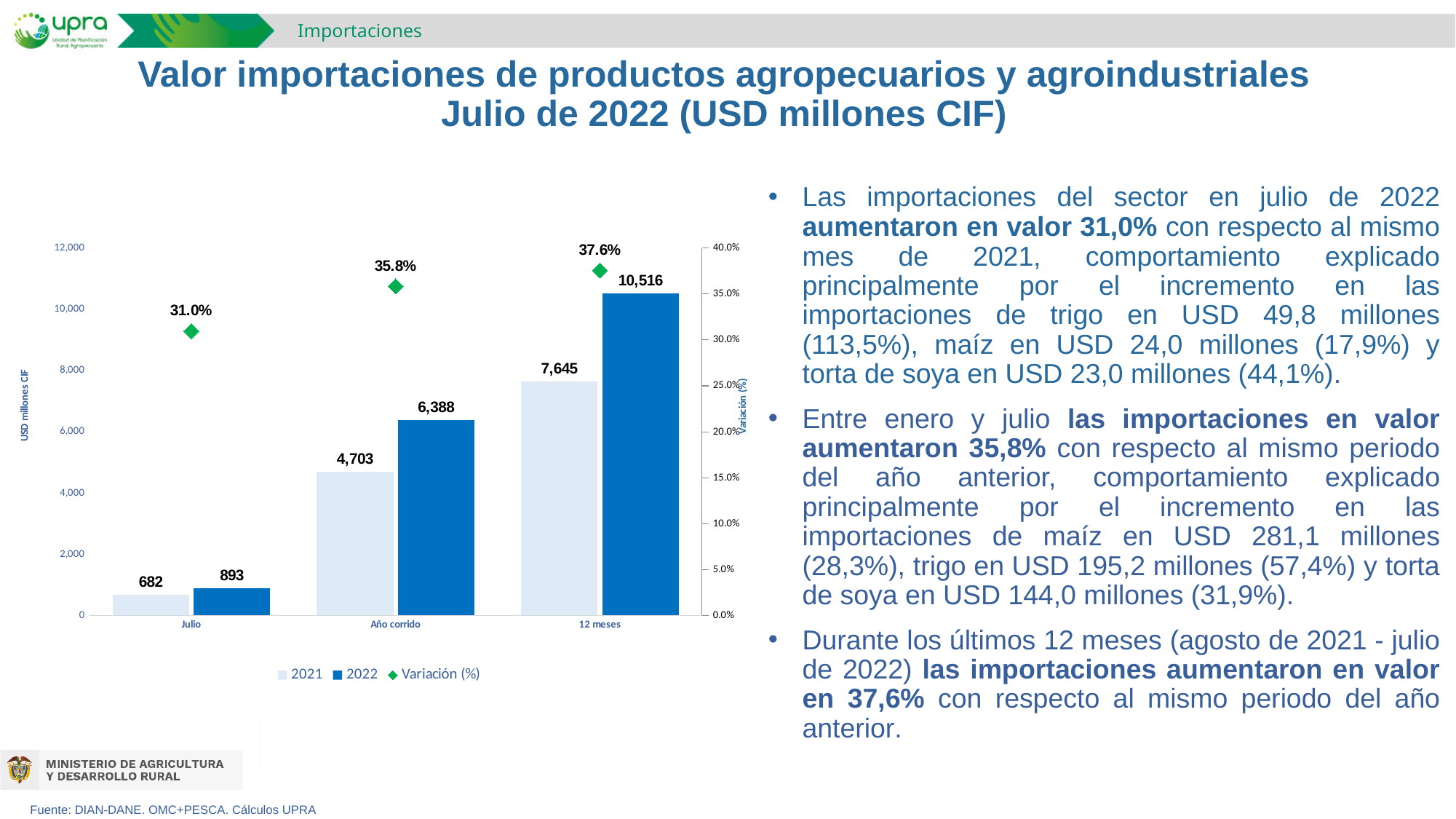
Is the 2021 value for 'Año corrido' greater or less than 4,000? greater What is the value for 2021 in the 'Julio' category? 682 What kind of chart is used to show the 2021 and 2022 values? bar chart What is the Variación (%) value for the '12 meses' category? 37.6% How many categories are shown on the x axis? 3 What is the value for 2022 in the 'Año corrido' category? 6,388 Do the Variación (%) values rise or fall from 'Julio' to '12 meses'? rise Which category has the highest 2022 value? 12 meses Which category has the lowest Variación (%) value? Julio How many series does the legend list? 3 What is the difference between the 2022 and 2021 values for '12 meses'? 2,871 Which is larger in the 'Julio' category, the 2021 value or the 2022 value? 2022